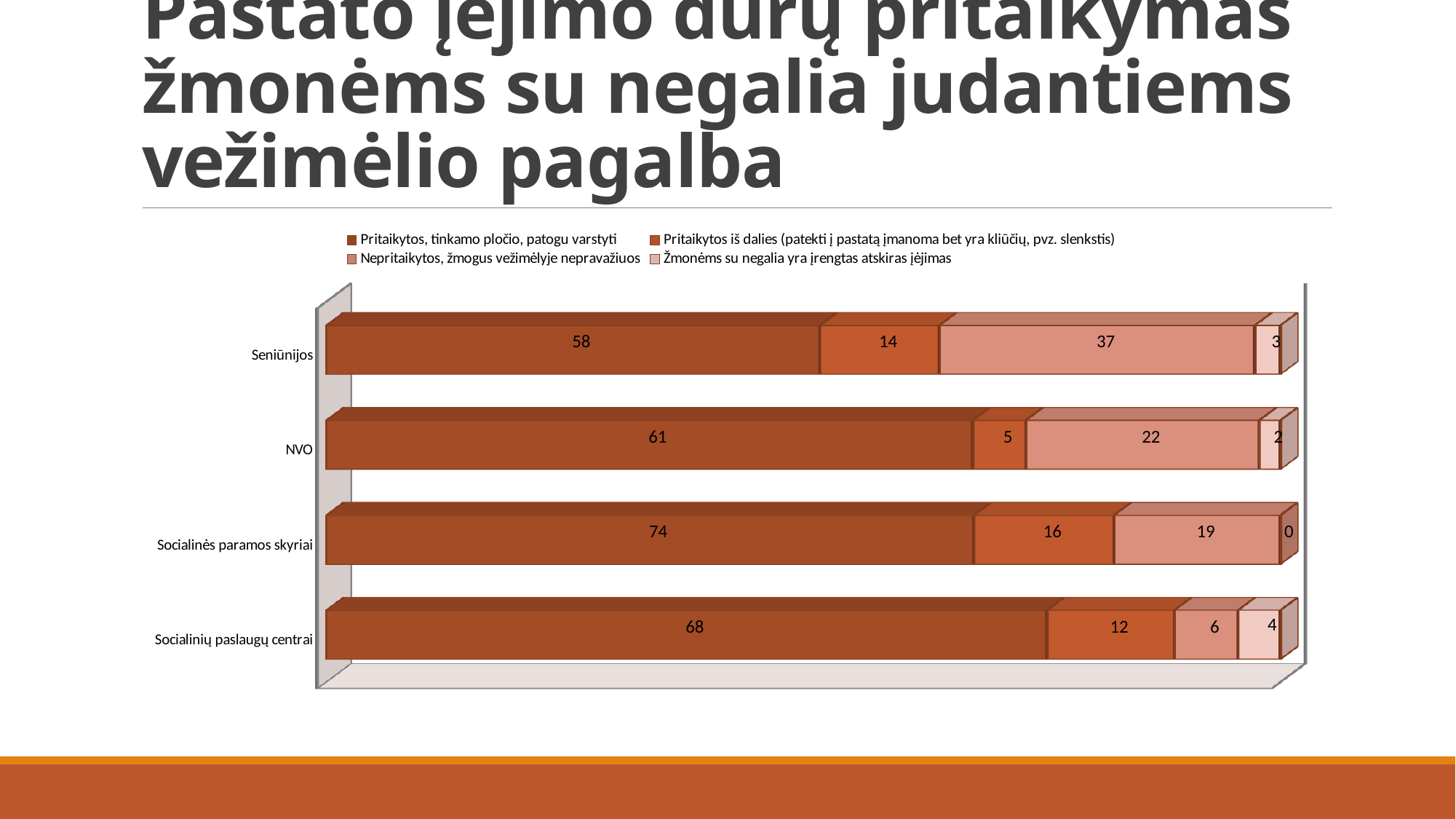
Which is larger: the "Nepritaikytos, žmogus vežimėlyje nepravažiuos" value for Seniūnijos or for Socialinės paramos skyriai? Seniūnijos What is the difference between the "Pritaikytos iš dalies" values for Socialinės paramos skyriai and NVO? 11 How many categories are plotted on the chart? 4 What is the total of the stacked bar for Seniūnijos? 112 What kind of chart is shown on the slide? Stacked bar chart Which category has the highest value for "Pritaikytos, tinkamo pločio, patogu varstyti"? Socialinės paramos skyriai What is the value of "Nepritaikytos, žmogus vežimėlyje nepravažiuos" for NVO? 22 What is the value of "Pritaikytos, tinkamo pločio, patogu varstyti" for Seniūnijos? 58 What is the total of the stacked bar for Socialinių paslaugų centrai? 90 What is the value of "Žmonėms su negalia yra įrengtas atskiras įėjimas" for Socialinių paslaugų centrai? 4 Which category has the lowest value for "Nepritaikytos, žmogus vežimėlyje nepravažiuos"? Socialinių paslaugų centrai How many series does the legend list? 4